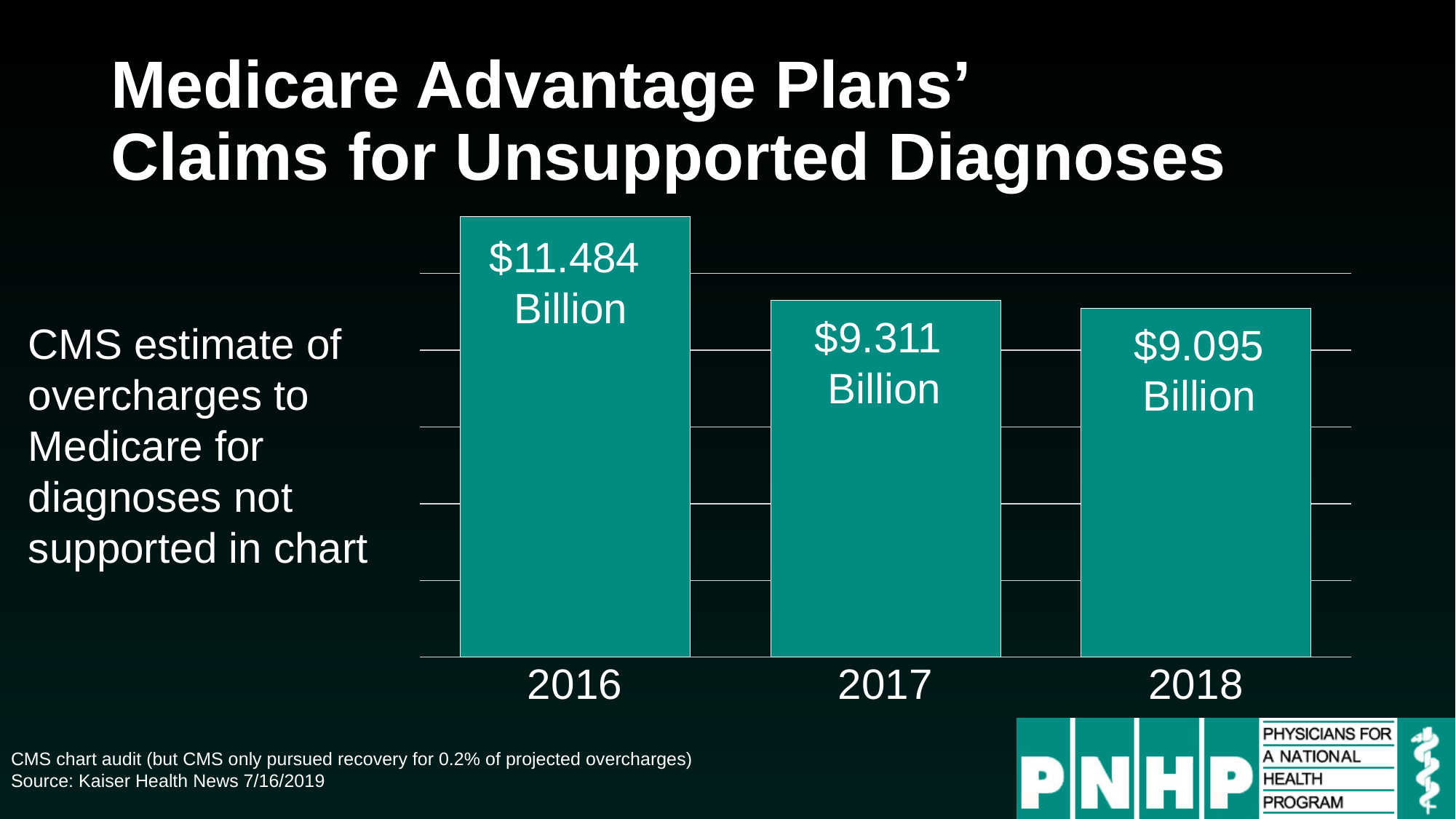
Which is larger, the value for 2017 or the value for 2018? 2017 What is the value for 2018? $9.095 Billion What is the value for 2016? $11.484 Billion Which year has the highest value? 2016 What is the value for 2017? $9.311 Billion What is the difference between the 2016 and 2018 values? $2.389 Billion What kind of chart is shown on the slide? Bar chart How many years are shown on the chart? 3 What is the difference between the 2016 and 2017 values? $2.173 Billion Do the values rise or fall from 2016 to 2018? Fall Which year has the lowest value? 2018 What is the difference between the 2017 and 2018 values? $0.216 Billion